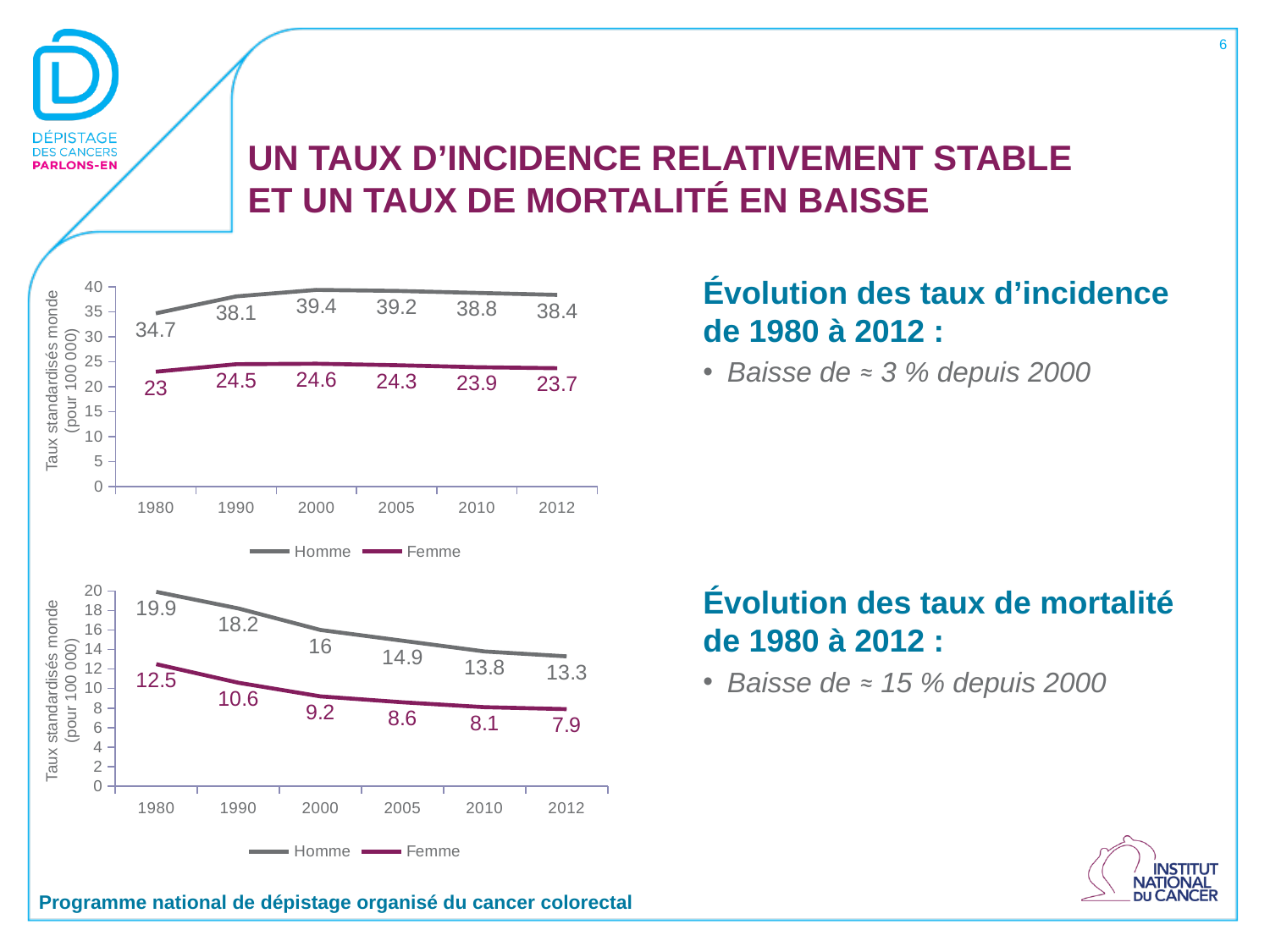
In the top chart, what is the value for Homme in 2000? 39.4 In the bottom chart, what is the value for Homme in 2012? 13.3 In the top chart, in which year is the Homme value highest? 2000 In the top chart, what is the difference between the Homme values in 2012 and 1980? 3.7 In the bottom chart, what is the difference between the Homme and Femme values in 1980? 7.4 In the bottom chart, in which year is the Femme value lowest? 2012 In the bottom chart, which is larger: the Homme value in 2010 or the Femme value in 1980? Homme in 2010 In the bottom chart, do the Homme values rise or fall from 1980 to 2012? fall What type of chart is the bottom chart? line chart How many years are shown on the x axis of the top chart? 6 In the bottom chart, what is the value for Femme in 2005? 8.6 In the top chart, what is the value for Femme in 1980? 23